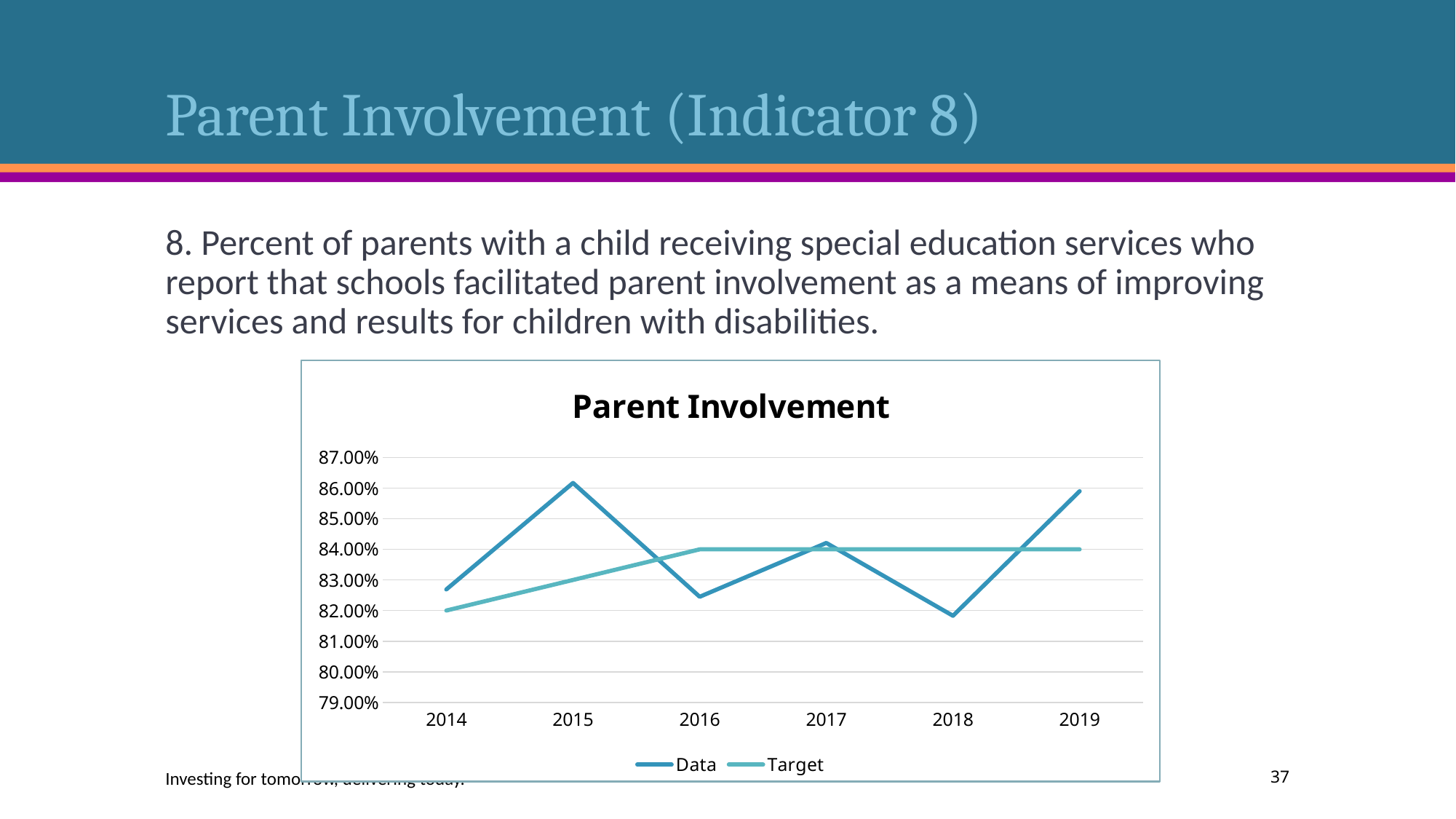
How many years are plotted along the x axis? 6 Does the Target series rise or fall from 2014 to 2016? rise Is the Data value for 2018 greater or less than 82.00%? less How many series does the legend list? 2 In 2016, which is larger, the Data value or the Target value? Target What is the title of the chart? Parent Involvement What type of chart is shown on the slide? line chart Is the Data value for 2015 greater or less than 85.00%? greater What is the Target value for 2019? 84.00% In which year is the Data series lowest? 2018 Is the Data value for 2016 greater or less than 83.00%? less What is the Target value for 2014? 82.00%